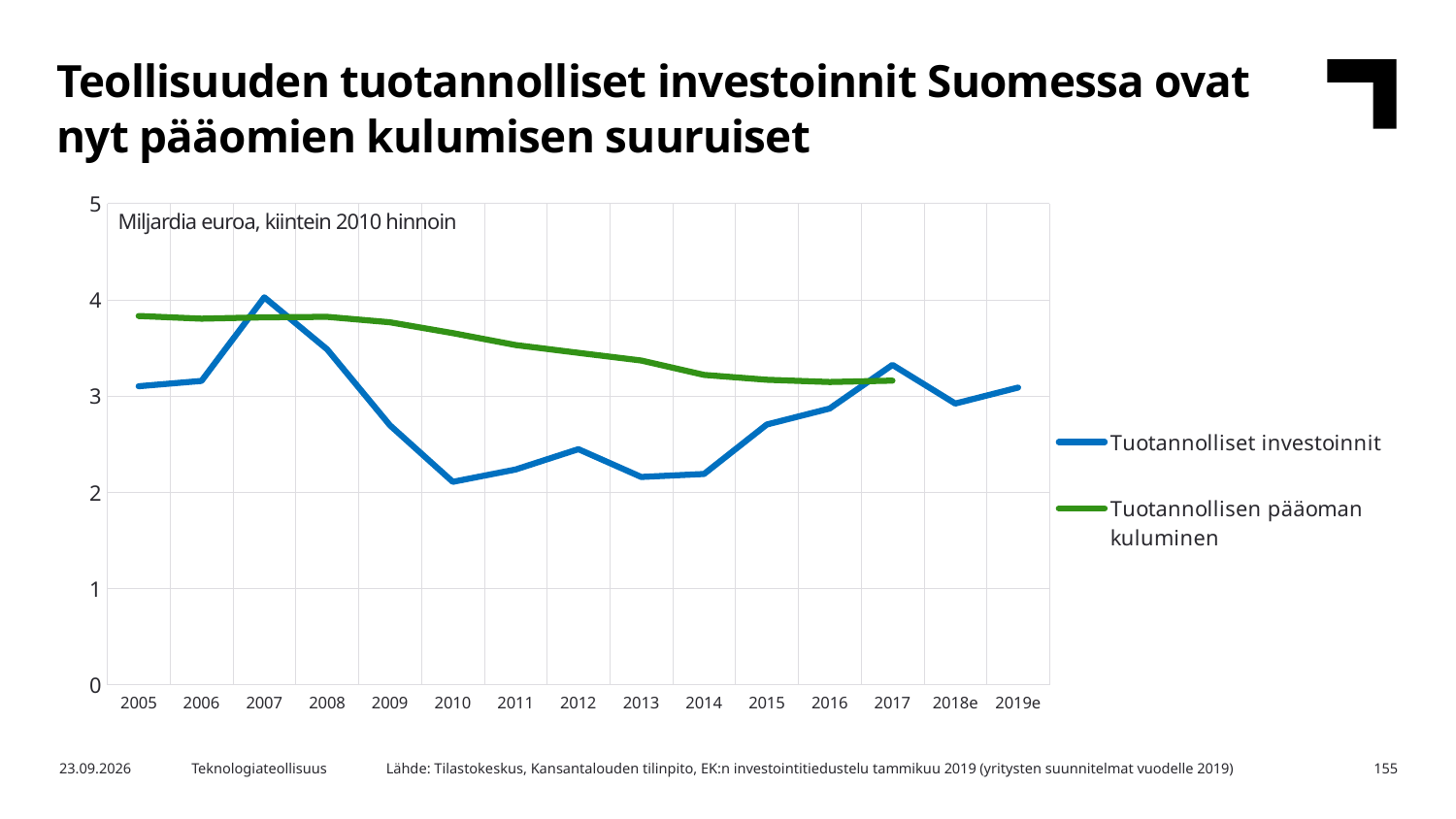
In which year does the Tuotannolliset investoinnit series reach its highest value? 2007 Is the value for Tuotannolliset investoinnit in 2010 greater or less than 3? less Is the value for Tuotannollisen pääoman kuluminen in 2005 greater or less than 3? greater What kind of chart is shown on the slide? line chart How many series does the legend list? 2 What unit is stated in the text inside the chart area? Miljardia euroa, kiintein 2010 hinnoin Does the Tuotannollisen pääoman kuluminen series rise or fall from 2005 to 2017? fall Is the value for Tuotannolliset investoinnit in 2013 greater or less than 2? greater In 2010, which series has the larger value, Tuotannolliset investoinnit or Tuotannollisen pääoman kuluminen? Tuotannollisen pääoman kuluminen Which series is drawn in green? Tuotannollisen pääoman kuluminen How many years are shown on the x axis? 15